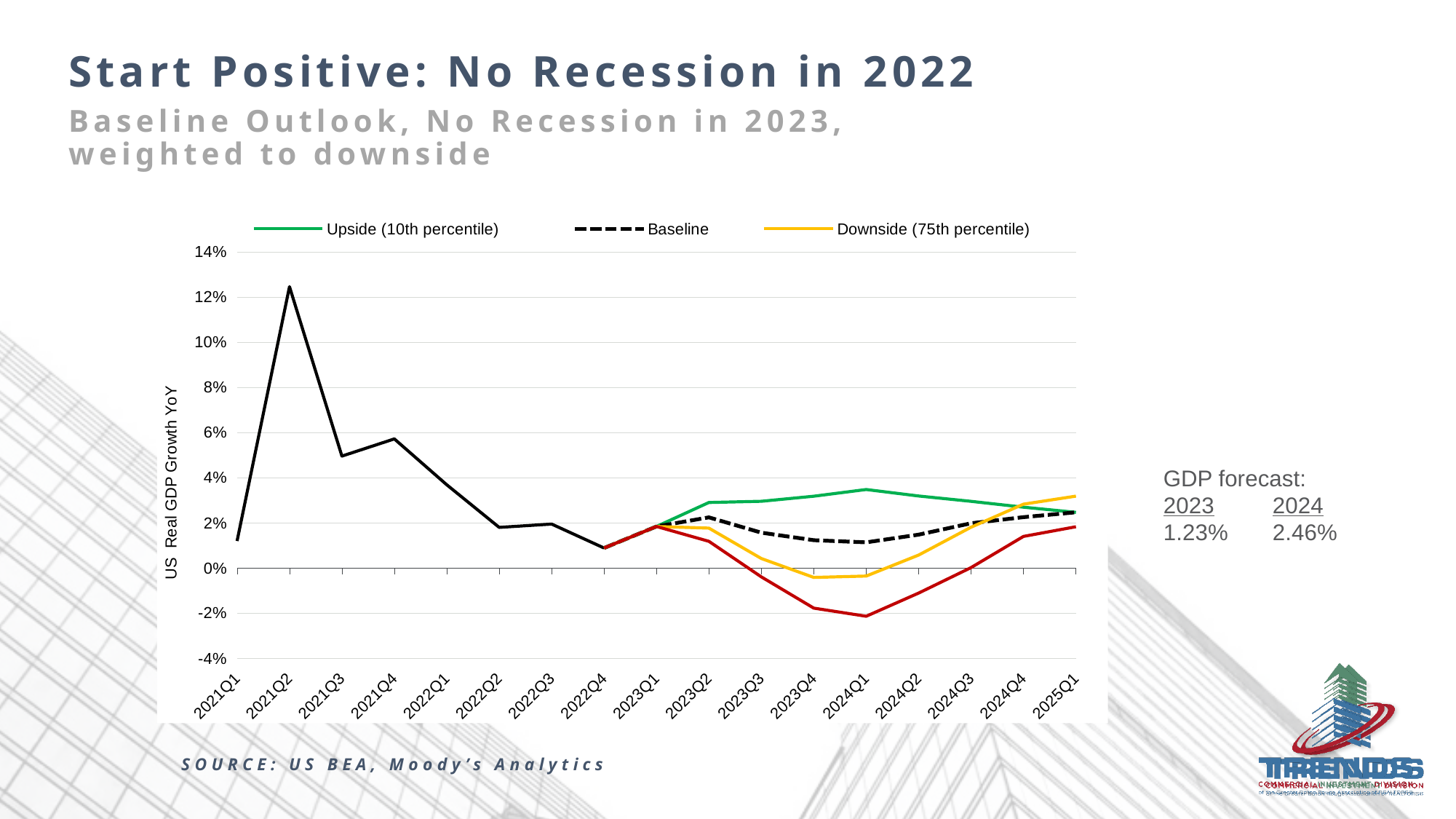
Is the value plotted for 2021Q2 greater or less than 10%? greater Does the Downside (75th percentile) line rise or fall from 2024Q1 to 2025Q1? rise Among the three legend series, which has the lowest value at 2024Q1? Downside (75th percentile) Is the Baseline value for 2024Q1 greater or less than 2%? less At 2024Q1, which is larger: the Upside (10th percentile) value or the Downside (75th percentile) value? Upside (10th percentile) What is the title of the chart's y axis? US Real GDP Growth YoY Is the Downside (75th percentile) value for 2023Q4 greater or less than 2%? less At which quarter does the plotted line reach its highest value? 2021Q2 What kind of chart is shown on the slide? line chart How many quarters are labelled along the x axis of the chart? 17 How many series does the chart legend list? 3